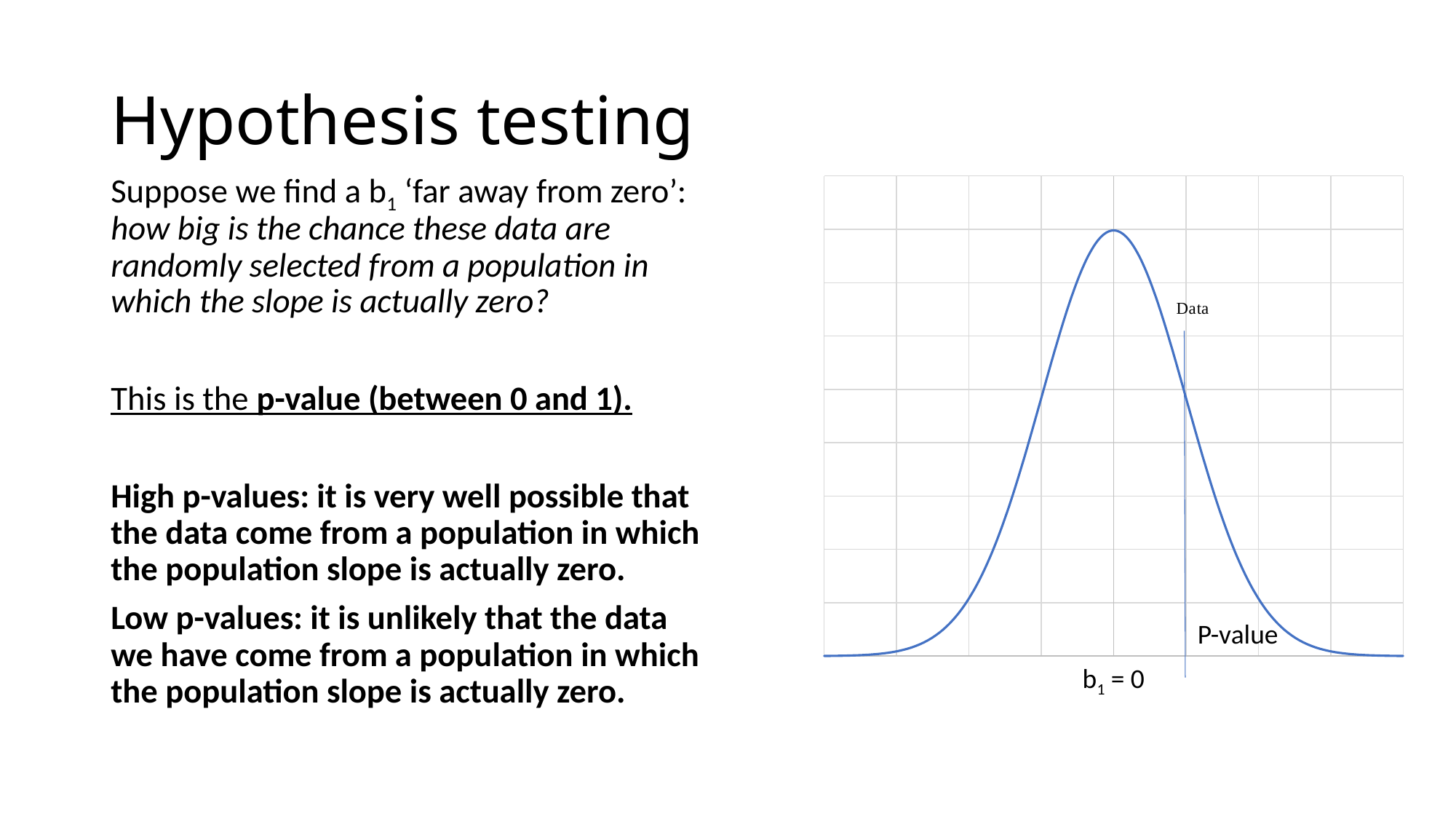
Is the vertical line labelled 'Data' to the left or to the right of the peak of the curve? right What shape does the plotted line on the chart have? a bell curve Does the curve rise or fall as it moves from the left edge of the chart toward the peak? rise How many curves are plotted on the chart? 1 Is the curve higher at the peak or at the vertical line labelled 'Data'? at the peak What label is written below the peak of the curve on the chart? b1 = 0 What kind of chart is shown on the right of the slide? line chart Does the curve rise or fall as it moves from the peak toward the right edge of the chart? fall